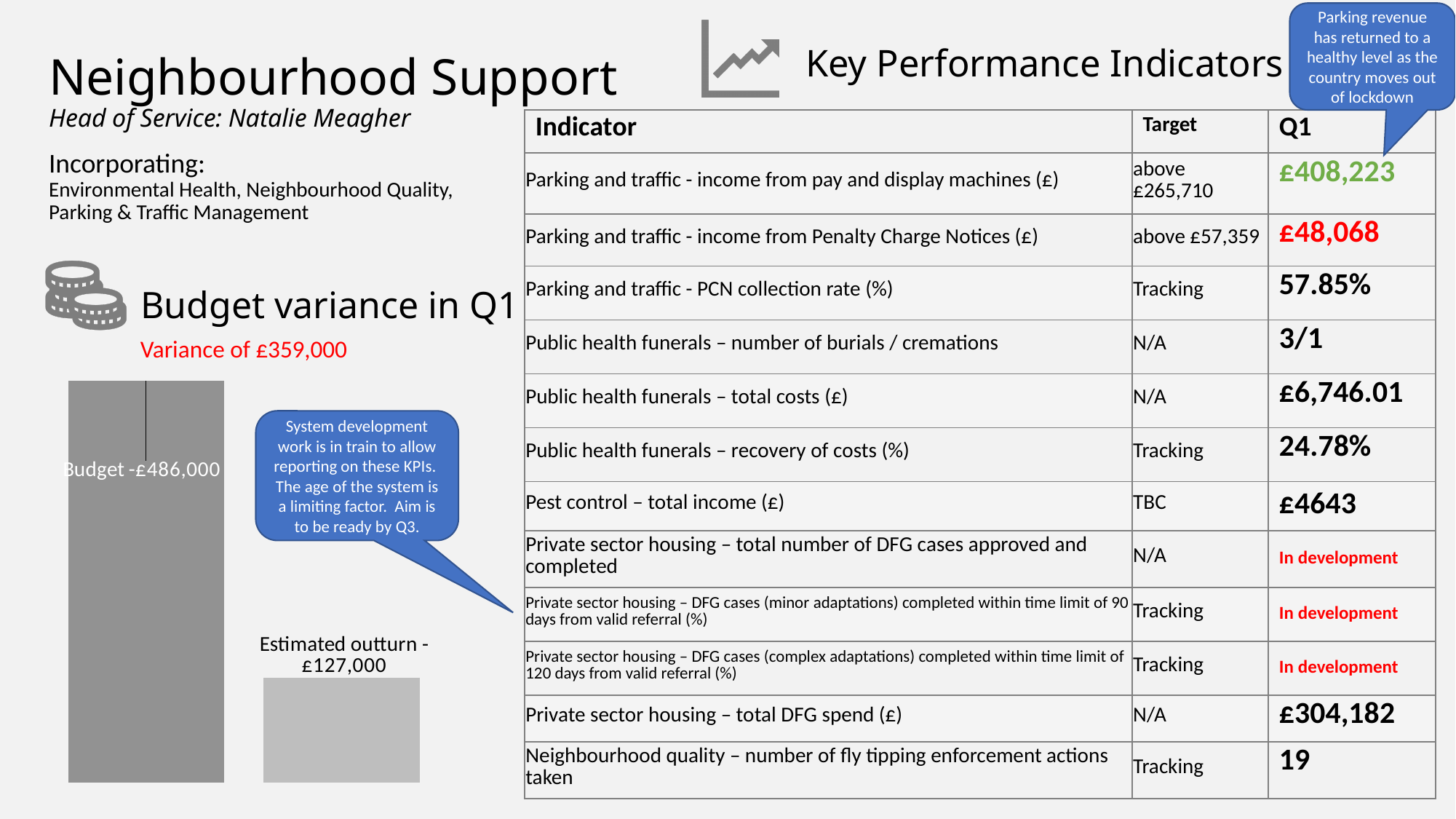
In the 'Budget variance in Q1' chart, what value is labelled for Estimated outturn? £127,000 What is the title of the bar chart on the left of the slide? Budget variance in Q1 In the 'Budget variance in Q1' chart, which bar is the shortest? Estimated outturn In the 'Budget variance in Q1' chart, which bar is the tallest? Budget In the 'Budget variance in Q1' chart, which bar is taller, Budget or Estimated outturn? Budget How many bars does the 'Budget variance in Q1' chart show? 2 What variance amount is stated in red above the 'Budget variance in Q1' chart? Variance of £359,000 In the 'Budget variance in Q1' chart, what value is labelled for Budget? £486,000 What kind of chart is shown under the heading 'Budget variance in Q1'? bar chart What is the difference between the Budget value and the Estimated outturn value in the 'Budget variance in Q1' chart? £359,000